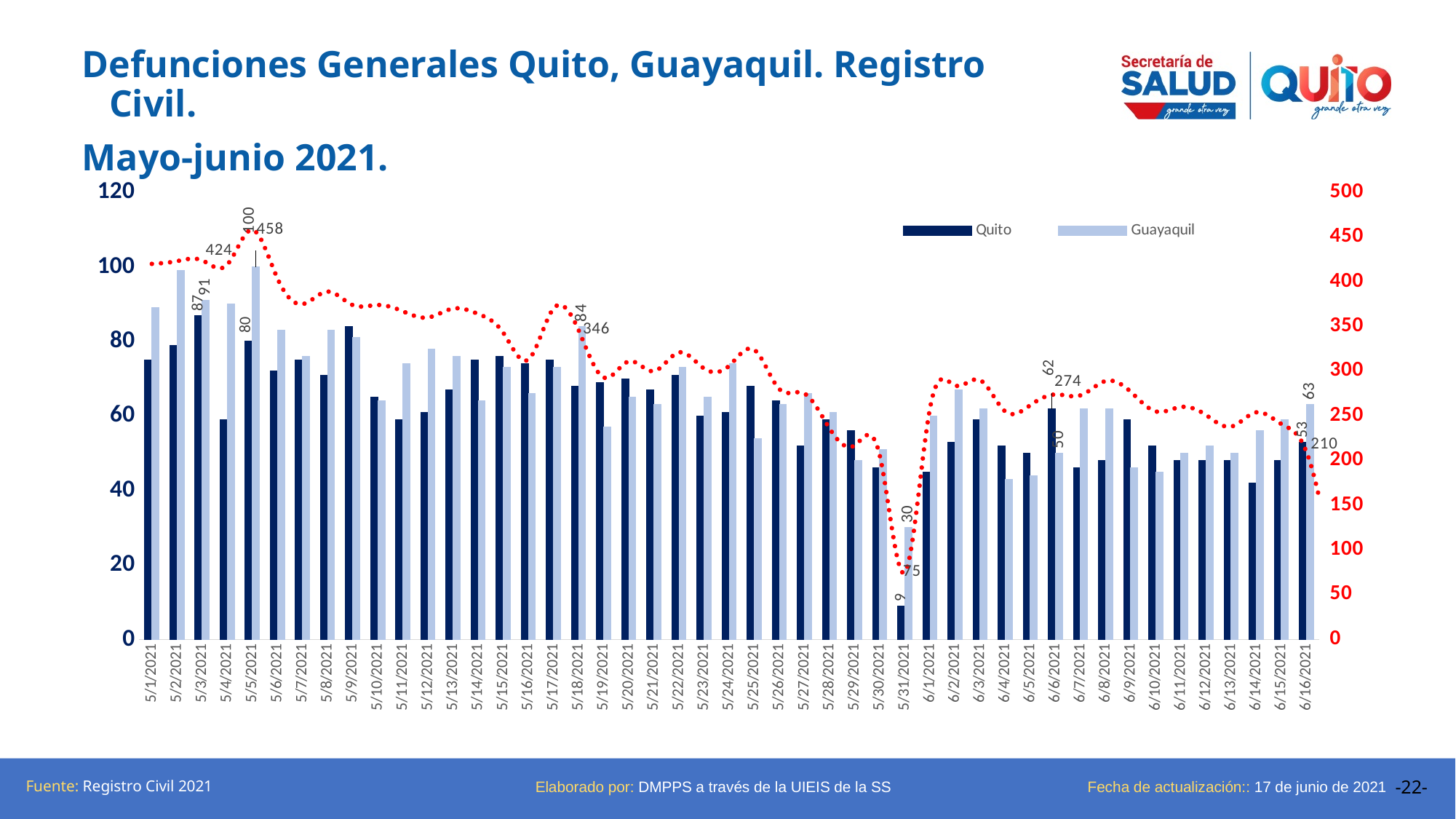
What is the difference between the Guayaquil and Quito values on 5/31/2021? 21 Do the Quito values generally rise or fall from 5/1/2021 to 6/16/2021? fall Is the Quito value on 5/1/2021 greater or less than 60? greater On which date is the Guayaquil bar highest? 5/5/2021 On 6/6/2021, which is larger, the Quito value or the Guayaquil value? Quito How many series does the legend list? 2 What is the Guayaquil value on 5/5/2021? 100 What is the Quito value on 5/31/2021? 9 What is the Guayaquil value on 6/16/2021? 63 On which date is the Quito bar lowest? 5/31/2021 What is the Quito value on 6/6/2021? 62 What kind of chart is shown on the slide? bar chart with a line